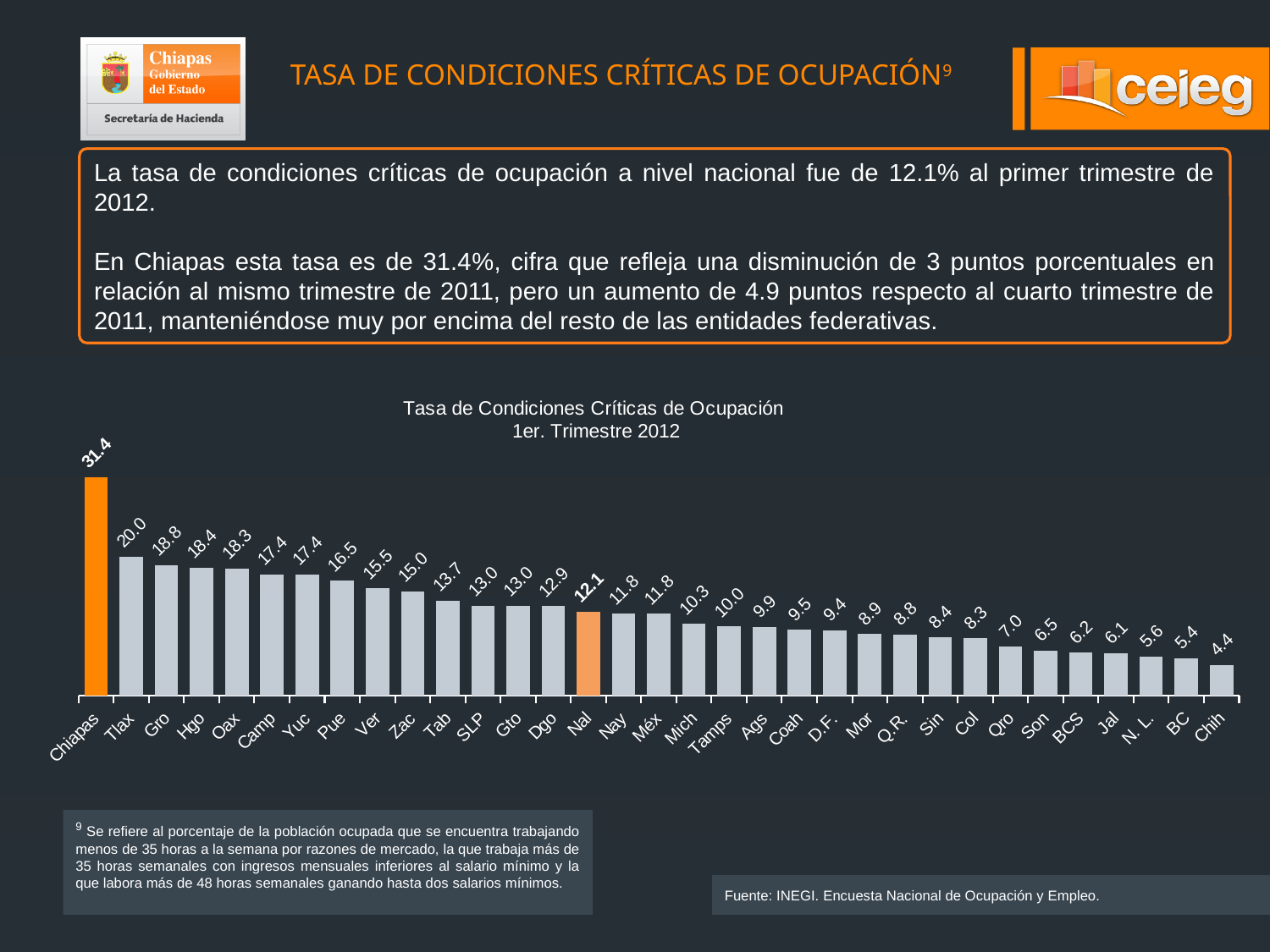
Do the values rise or fall from left to right along the x axis? Fall What is the value for Tlax? 20.0 What is the value for Chih? 4.4 What is the difference between the values for Tlax and Gro? 1.2 Which is larger, the value for Oax or the value for Pue? Oax How many bars are plotted in the chart? 33 What is the difference between the values for Chiapas and Nal? 19.3 Which category has the lowest value? Chih What is the value for Nal (national)? 12.1 Which category has the highest value? Chiapas What kind of chart is shown? Bar chart What is the value for Chiapas? 31.4